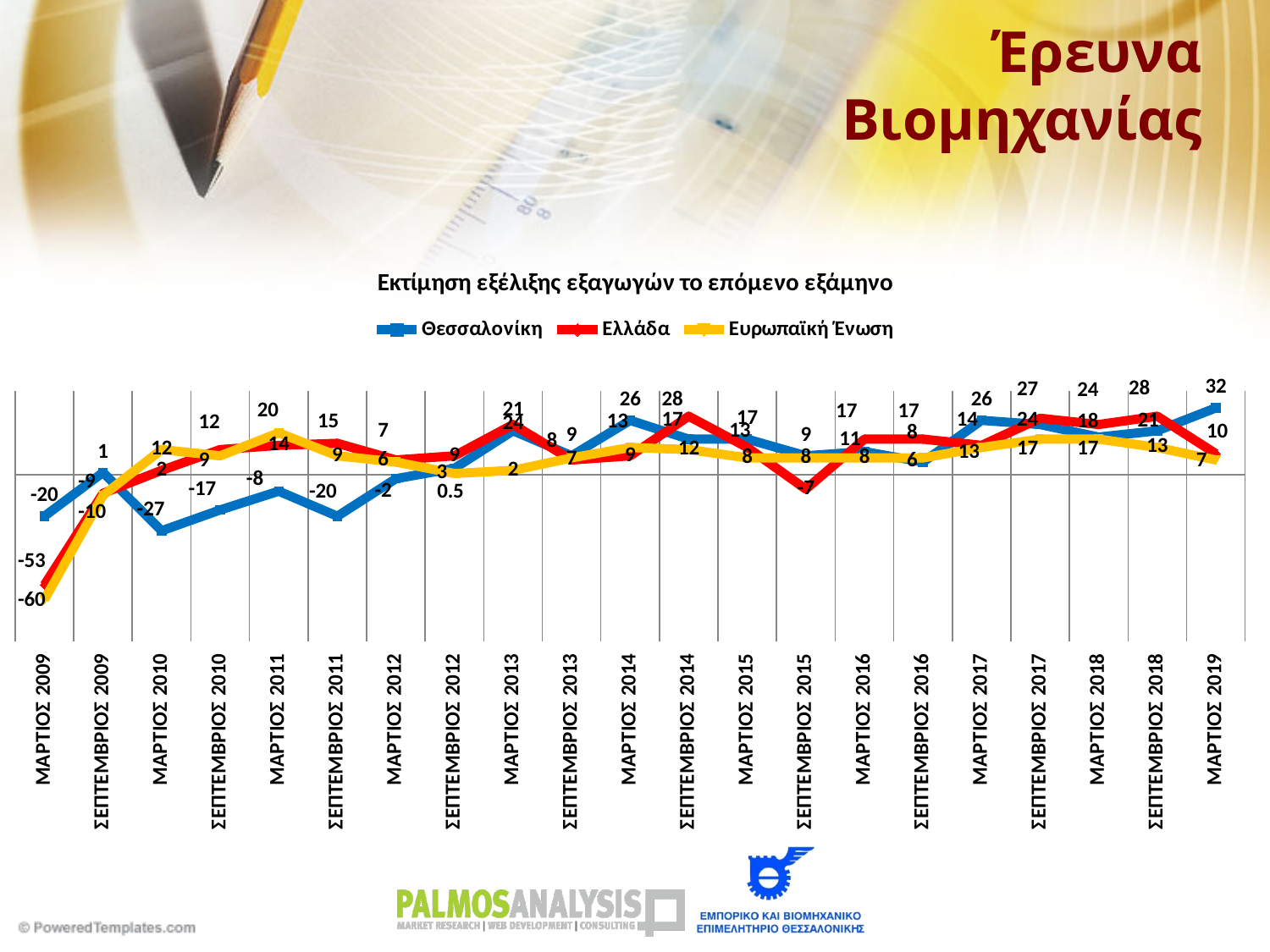
What is the value for Θεσσαλονίκη in ΜΑΡΤΙΟΣ 2019? 32 What is the title of the chart? Εκτίμηση εξέλιξης εξαγωγών το επόμενο εξάμηνο What is the value for Ελλάδα in ΣΕΠΤΕΜΒΡΙΟΣ 2015? -7 What kind of chart is shown on the slide? Line chart What is the value for Ευρωπαϊκή Ένωση in ΜΑΡΤΙΟΣ 2011? 20 What is the difference between the Θεσσαλονίκη and Ελλάδα values in ΜΑΡΤΙΟΣ 2019? 22 In ΜΑΡΤΙΟΣ 2014, which is larger: the value for Θεσσαλονίκη or for Ελλάδα? Θεσσαλονίκη How many time points are plotted along the x axis? 21 In which period does Θεσσαλονίκη reach its lowest value? ΜΑΡΤΙΟΣ 2010 In which period does Θεσσαλονίκη reach its highest value? ΜΑΡΤΙΟΣ 2019 What is the value for Ελλάδα in ΣΕΠΤΕΜΒΡΙΟΣ 2014? 28 How many series does the legend list? 3